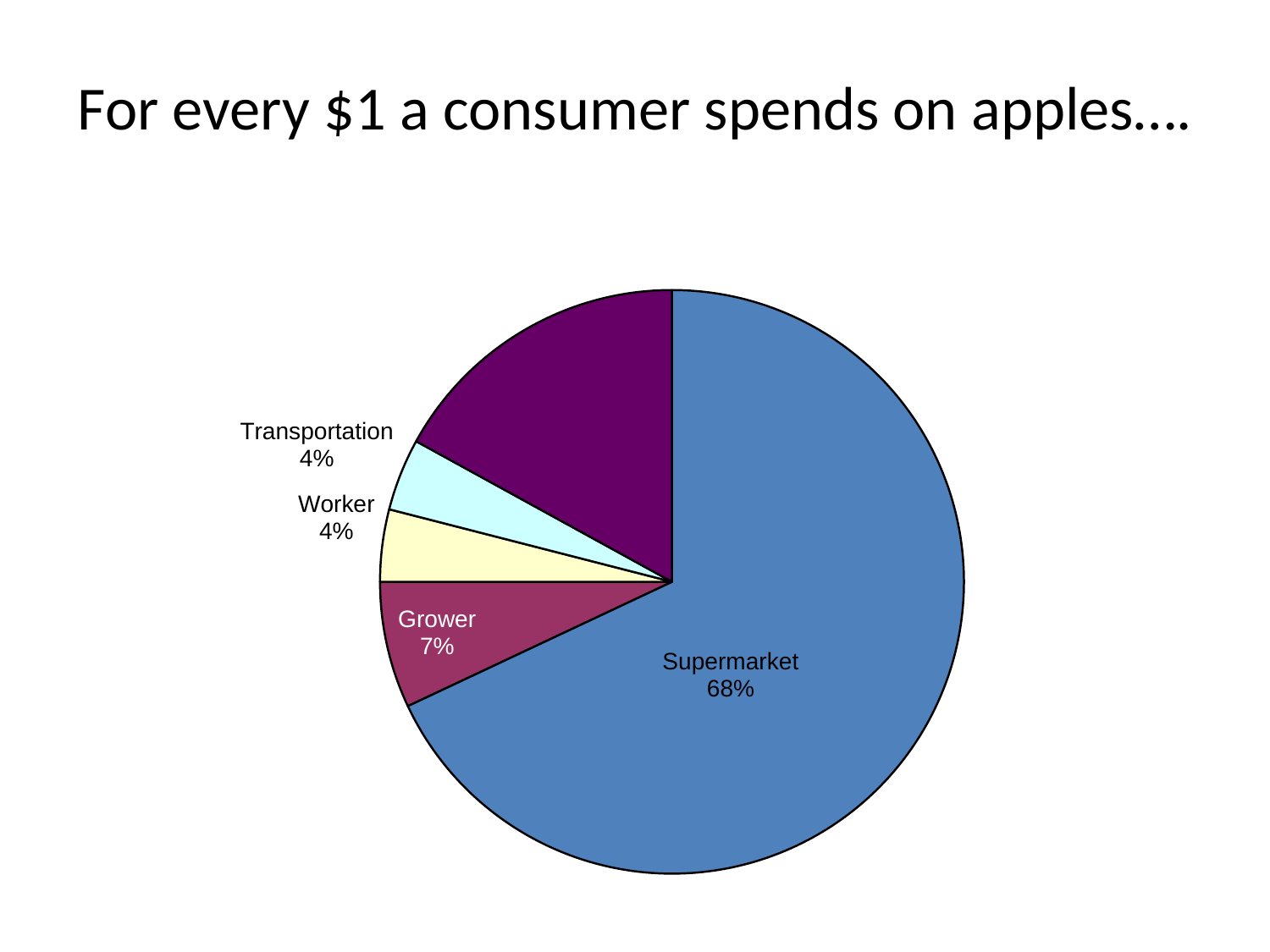
What is the value shown for Worker? 4% What is the title of the slide? For every $1 a consumer spends on apples…. What is the combined share of Worker and Transportation? 8% What is the difference between the Supermarket share and the Grower share? 61% What is the value shown for Grower? 7% What is the value shown for Transportation? 4% What kind of chart is shown on the slide? pie chart How many slices does the pie chart have? 5 Which slice of the pie is the largest? Supermarket What colour is the Supermarket slice? blue Which is larger, the Grower share or the Worker share? Grower What share of the pie does the Supermarket slice represent? 68%